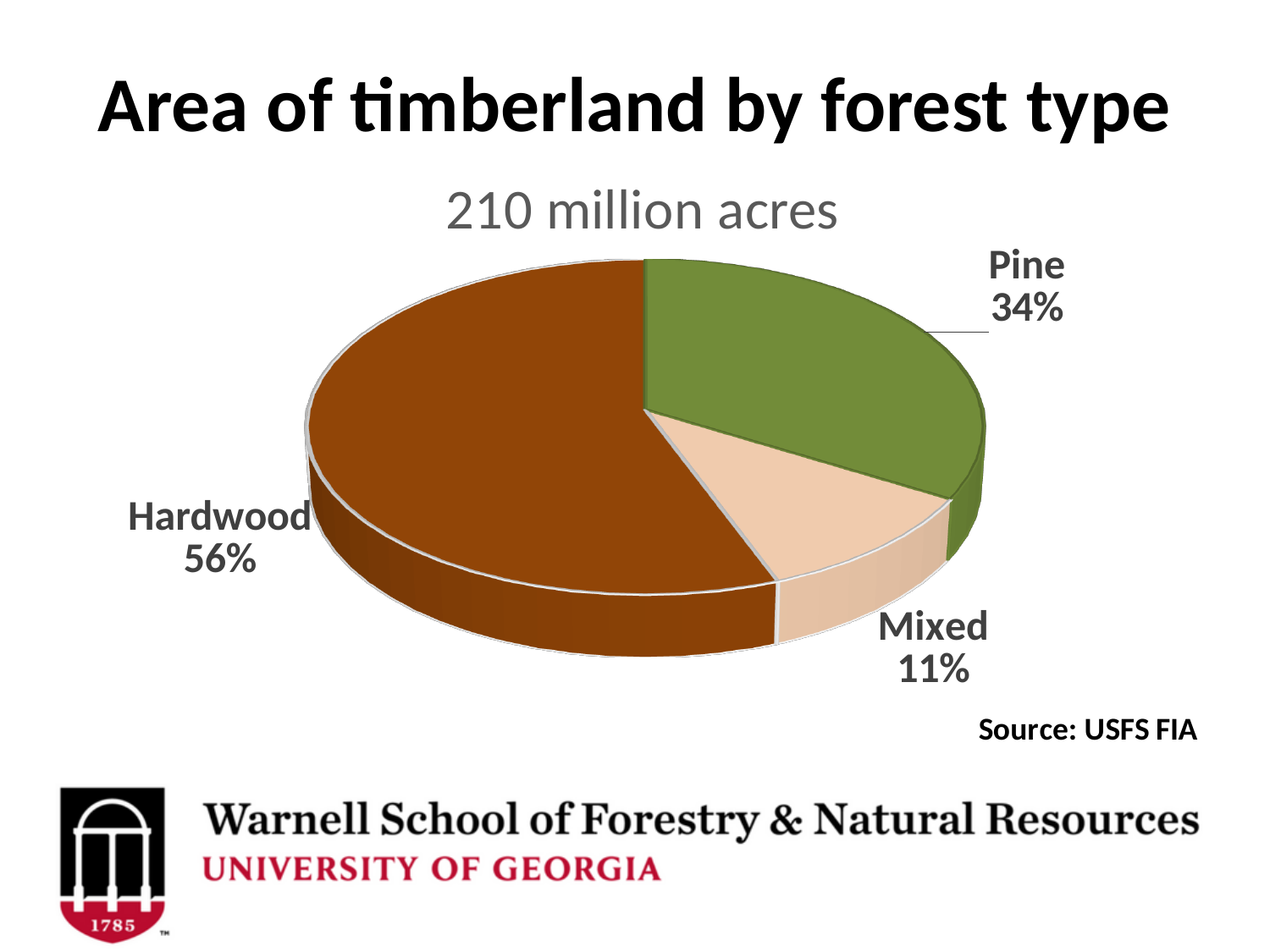
How many forest types are shown in the pie chart? 3 What share of timberland is Pine? 34% What share of timberland is Mixed? 11% What is the chart's title? 210 million acres Which is larger, the Pine share or the Mixed share? Pine What total area of timberland does the chart represent? 210 million acres Which forest type has the smallest share of timberland? Mixed How many percentage points larger is the Hardwood share than the Pine share? 22 What kind of chart is shown on the slide? Pie chart How many percentage points larger is the Pine share than the Mixed share? 23 Which forest type has the largest share of timberland? Hardwood What share of timberland is Hardwood? 56%